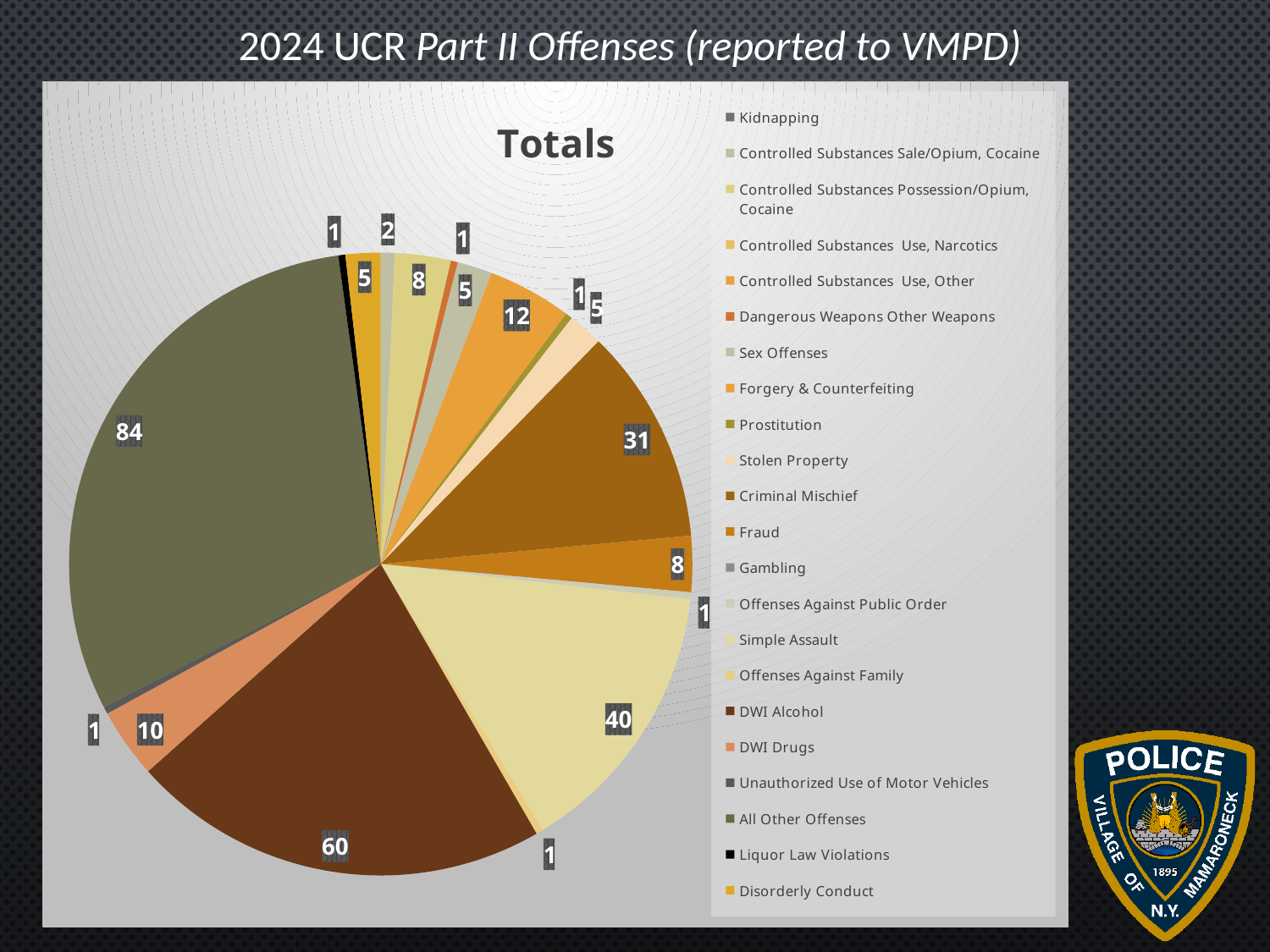
What is the difference between the largest slice (84) and the DWI Alcohol slice (60)? 24 What kind of chart is shown on the slide? pie chart What is the value for Simple Assault? 40 What is the value of the largest slice in the pie chart? 84 What is the value for DWI Alcohol? 60 What is the title of the chart? Totals What is the smallest value shown as a data label on the pie chart? 1 Which is larger, the DWI Alcohol slice or the Simple Assault slice? DWI Alcohol What is the value for DWI Drugs? 10 Which category has the largest slice in the pie chart? All Other Offenses How many categories does the chart legend list? 22 What is the value for Criminal Mischief? 31